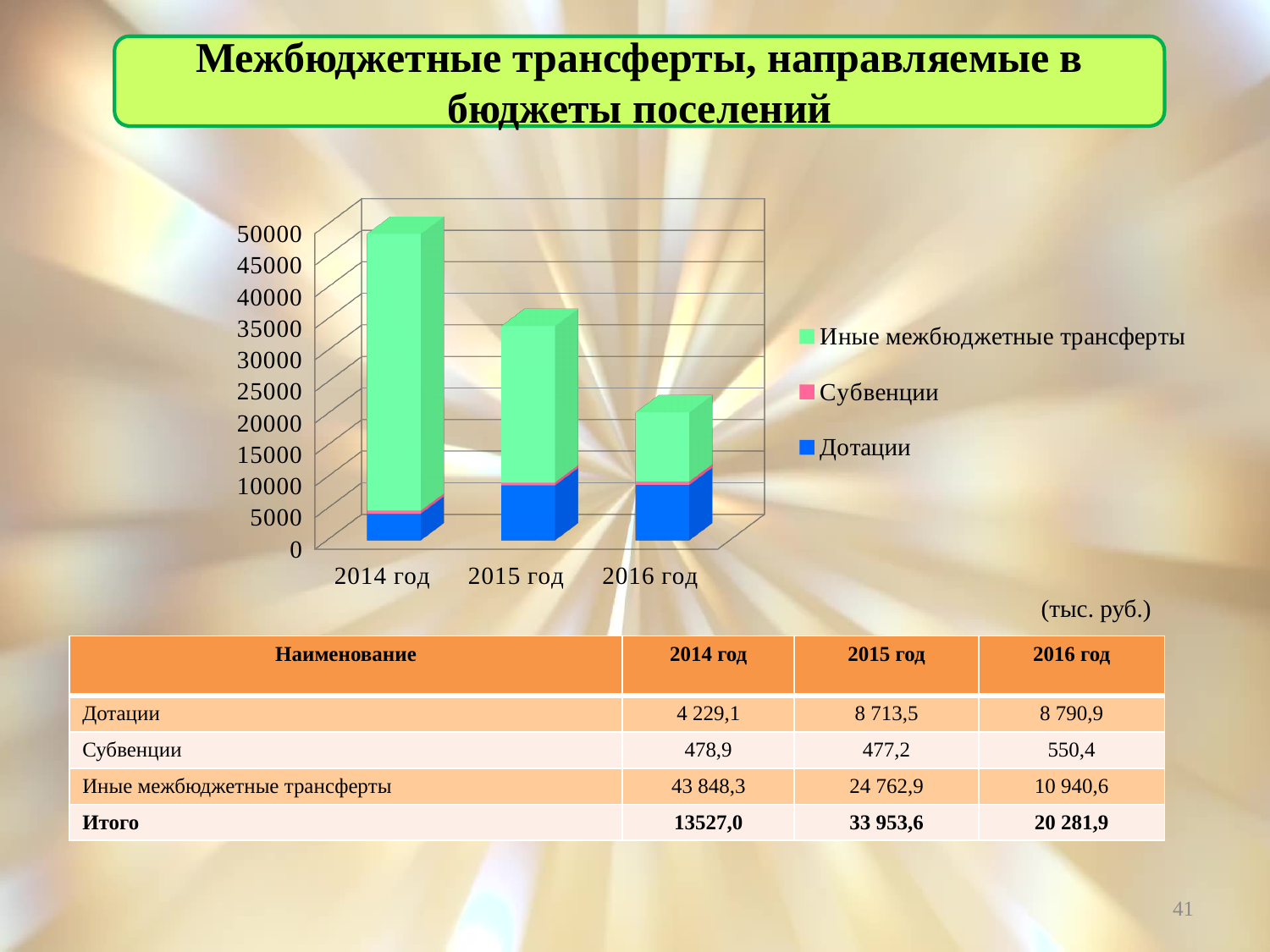
What is the value of Дотации for 2016 год? 8 790,9 What kind of chart is shown on the slide? Stacked bar chart Is the total height of the 2015 год stacked bar greater or less than 30000? greater What is the value of Субвенции for 2015 год? 477,2 Which year has the tallest stacked bar in the chart? 2014 год Which is larger: Дотации in 2015 год or Дотации in 2014 год? 2015 год Do the total heights of the stacked bars rise or fall from 2014 to 2016? Fall How many years (categories) are shown on the x axis of the chart? 3 What is the total of the 2016 год stacked bar (Дотации + Субвенции + Иные межбюджетные трансферты)? 20 281,9 What is the value of Иные межбюджетные трансферты for 2014 год? 43 848,3 Which year has the shortest stacked bar in the chart? 2016 год How many series does the chart legend list? 3